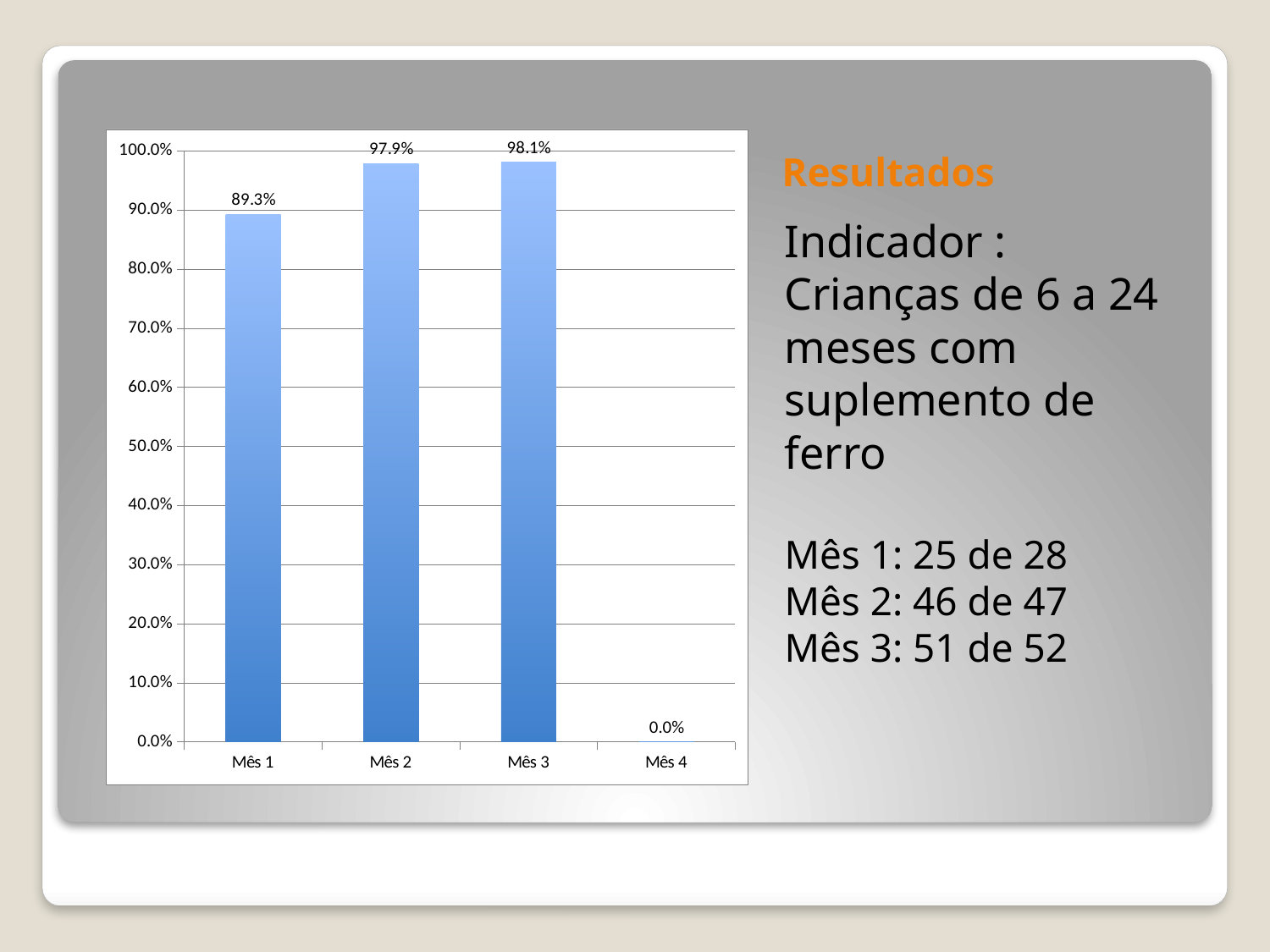
What is the difference between the values for Mês 2 and Mês 1? 8.6% What is the value for Mês 3? 98.1% Which category has the lowest value? Mês 4 What is the value for Mês 2? 97.9% What is the highest tick value shown on the y axis? 100.0% What is the value for Mês 1? 89.3% What kind of chart is shown on the slide? bar chart What is the value for Mês 4? 0.0% How many categories are shown on the x axis? 4 Which is larger, the value for Mês 1 or the value for Mês 2? Mês 2 Is the value for Mês 1 greater or less than 80.0%? greater Which category has the highest value? Mês 3